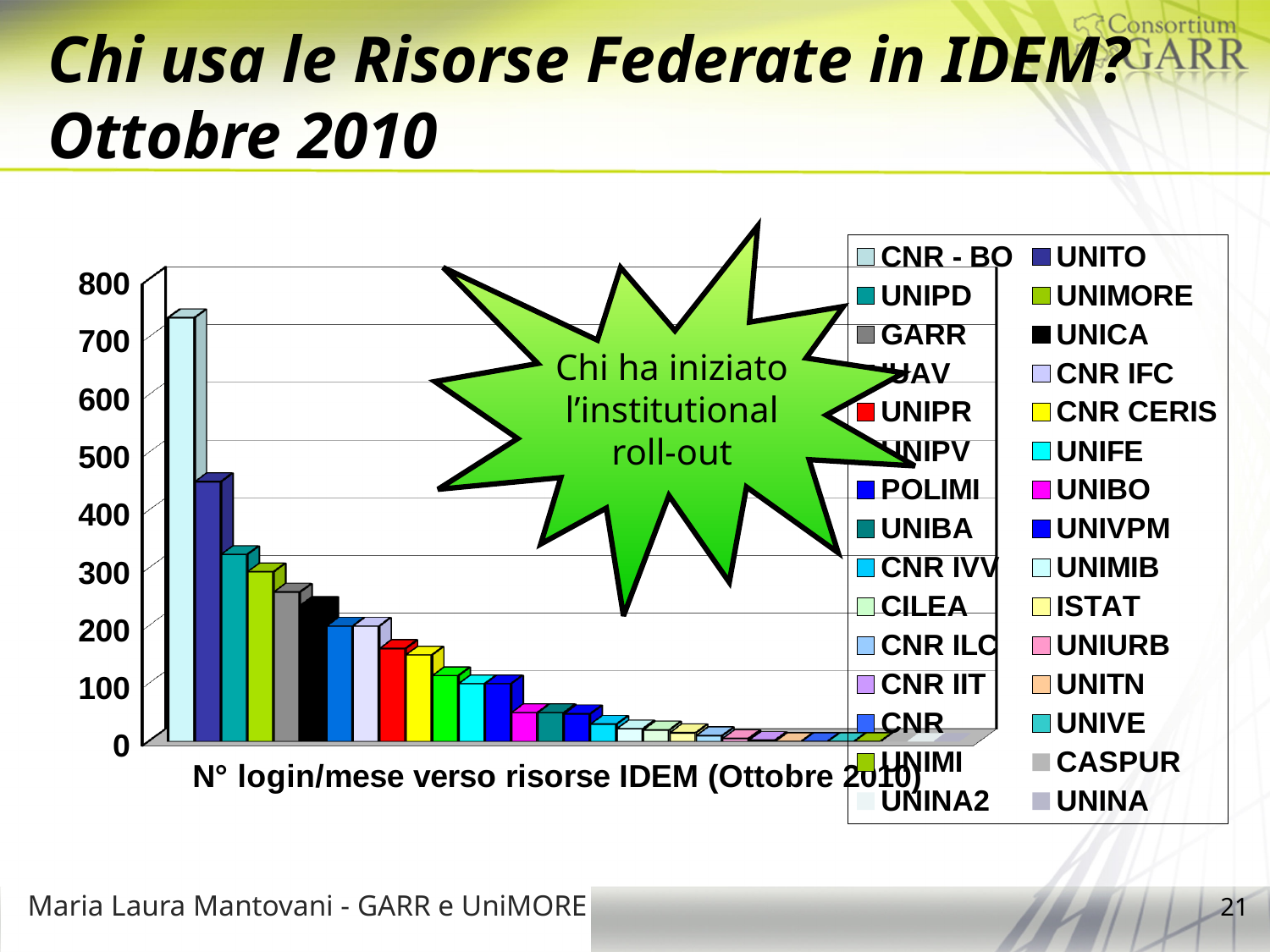
Which has more logins per month, CNR - BO or UNITO? CNR - BO Is the value for GARR greater or less than 300? less Which series has the highest number of logins per month? CNR - BO What kind of chart is shown on the slide? bar chart Do the bar values rise or fall from left to right across the chart? fall Is the value for UNIPR greater or less than 200? less Is the value for UNIPD greater or less than 300? greater What is the title shown below the x axis of the chart? N° login/mese verso risorse IDEM (Ottobre 2010) How many series does the chart legend list? 30